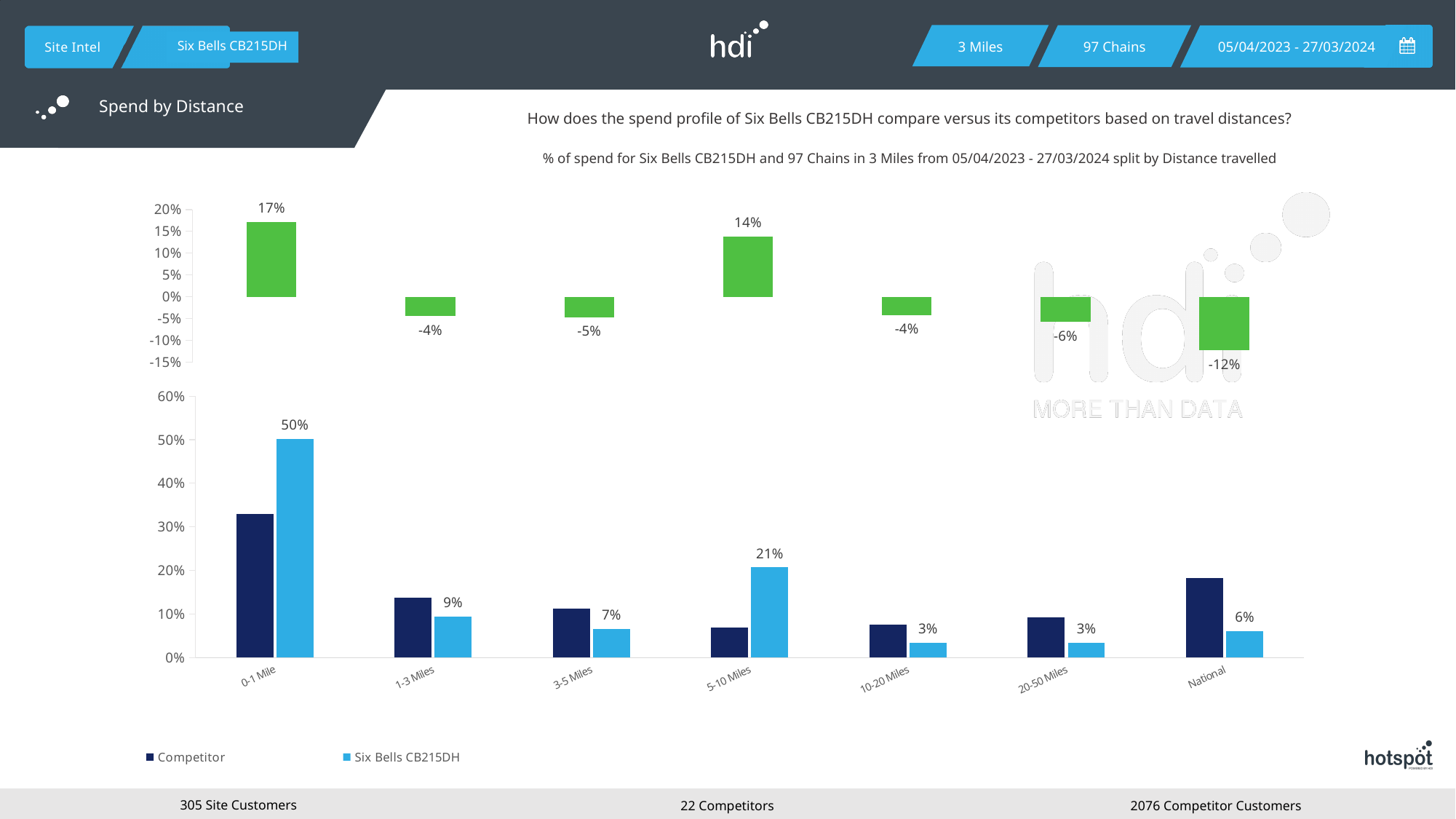
In the bottom chart, for the 1-3 Miles category, which series has the larger value: Competitor or Six Bells CB215DH? Competitor In the bottom chart, what is the value for Six Bells CB215DH in the 5-10 Miles category? 21% In the bottom chart, is the Competitor value for 0-1 Mile greater or less than 30%? greater What type of chart is the bottom chart? bar chart How many series does the legend of the bottom chart list? 2 In the bottom chart, is the Competitor value for National greater or less than 20%? less In the bottom chart, what is the value for Six Bells CB215DH in the 0-1 Mile category? 50% In the top chart with green bars, what is the lowest value shown? -12% How many distance categories are shown on the x axis of the bottom chart? 7 In the bottom chart, for the 0-1 Mile category, which series has the larger value: Competitor or Six Bells CB215DH? Six Bells CB215DH In the bottom chart, what is the difference between the Six Bells CB215DH values for 0-1 Mile and 5-10 Miles? 29% In the bottom chart, which distance category has the highest value for Six Bells CB215DH? 0-1 Mile